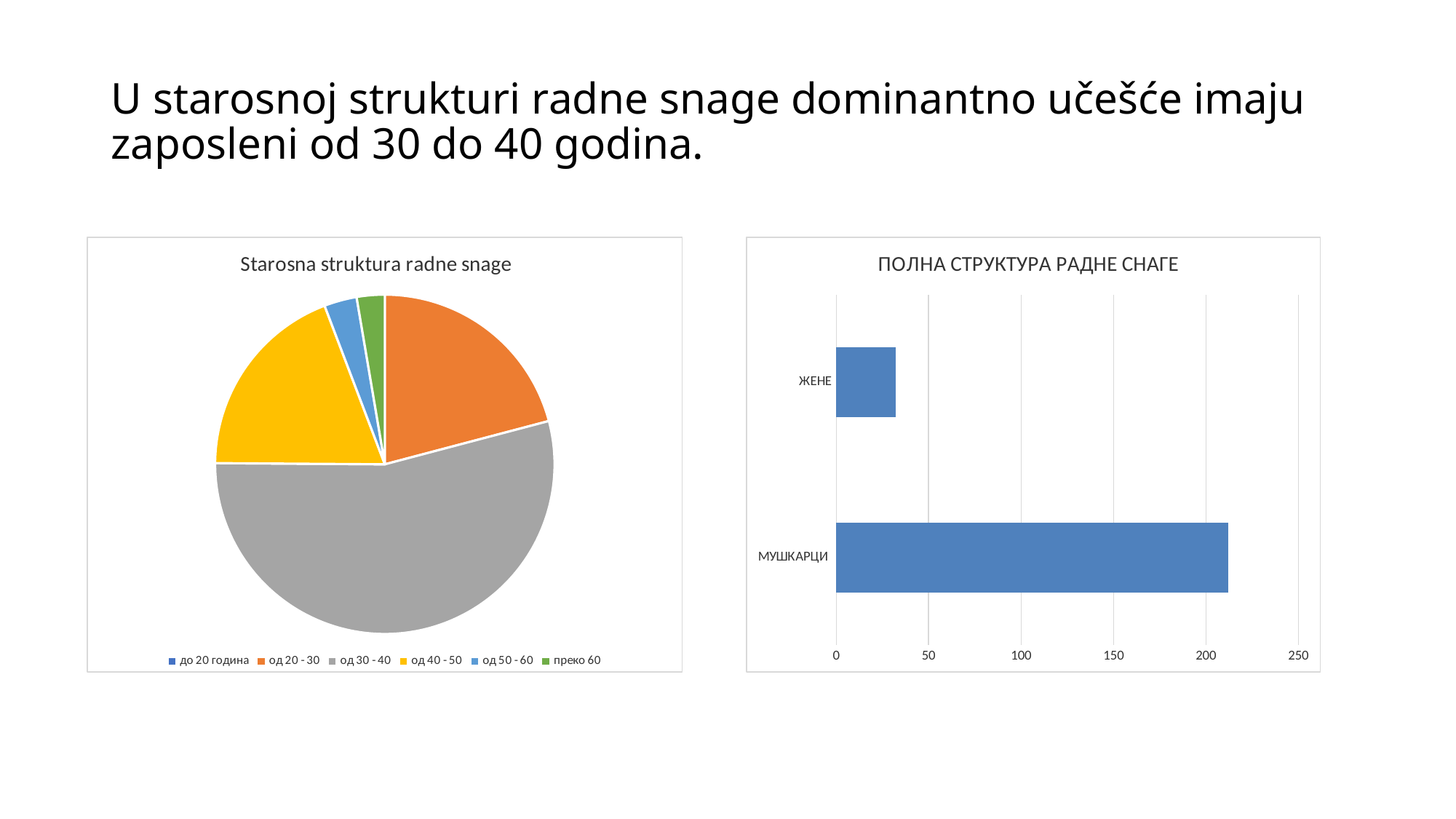
How many entries does the legend of the pie chart "Starosna struktura radne snage" list? 6 In the bar chart "ПОЛНА СТРУКТУРА РАДНЕ СНАГЕ", which category has the larger value, ЖЕНЕ or МУШКАРЦИ? МУШКАРЦИ In the bar chart "ПОЛНА СТРУКТУРА РАДНЕ СНАГЕ", is the value for МУШКАРЦИ greater or less than 200? greater In the pie chart "Starosna struktura radne snage", which age group has the largest slice? од 30 - 40 What kind of chart is the left chart titled "Starosna struktura radne snage"? pie chart What is the highest value shown on the horizontal axis of the bar chart "ПОЛНА СТРУКТУРА РАДНЕ СНАГЕ"? 250 In the pie chart "Starosna struktura radne snage", what colour is the slice for "од 40 - 50"? yellow What kind of chart is the right chart titled "ПОЛНА СТРУКТУРА РАДНЕ СНАГЕ"? bar chart In the bar chart "ПОЛНА СТРУКТУРА РАДНЕ СНАГЕ", is the value for ЖЕНЕ greater or less than 50? less In the pie chart "Starosna struktura radne snage", which is larger, the slice for "од 20 - 30" or the slice for "преко 60"? од 20 - 30 In the bar chart "ПОЛНА СТРУКТУРА РАДНЕ СНАГЕ", which category has the lowest value? ЖЕНЕ How many categories are shown in the bar chart "ПОЛНА СТРУКТУРА РАДНЕ СНАГЕ"? 2